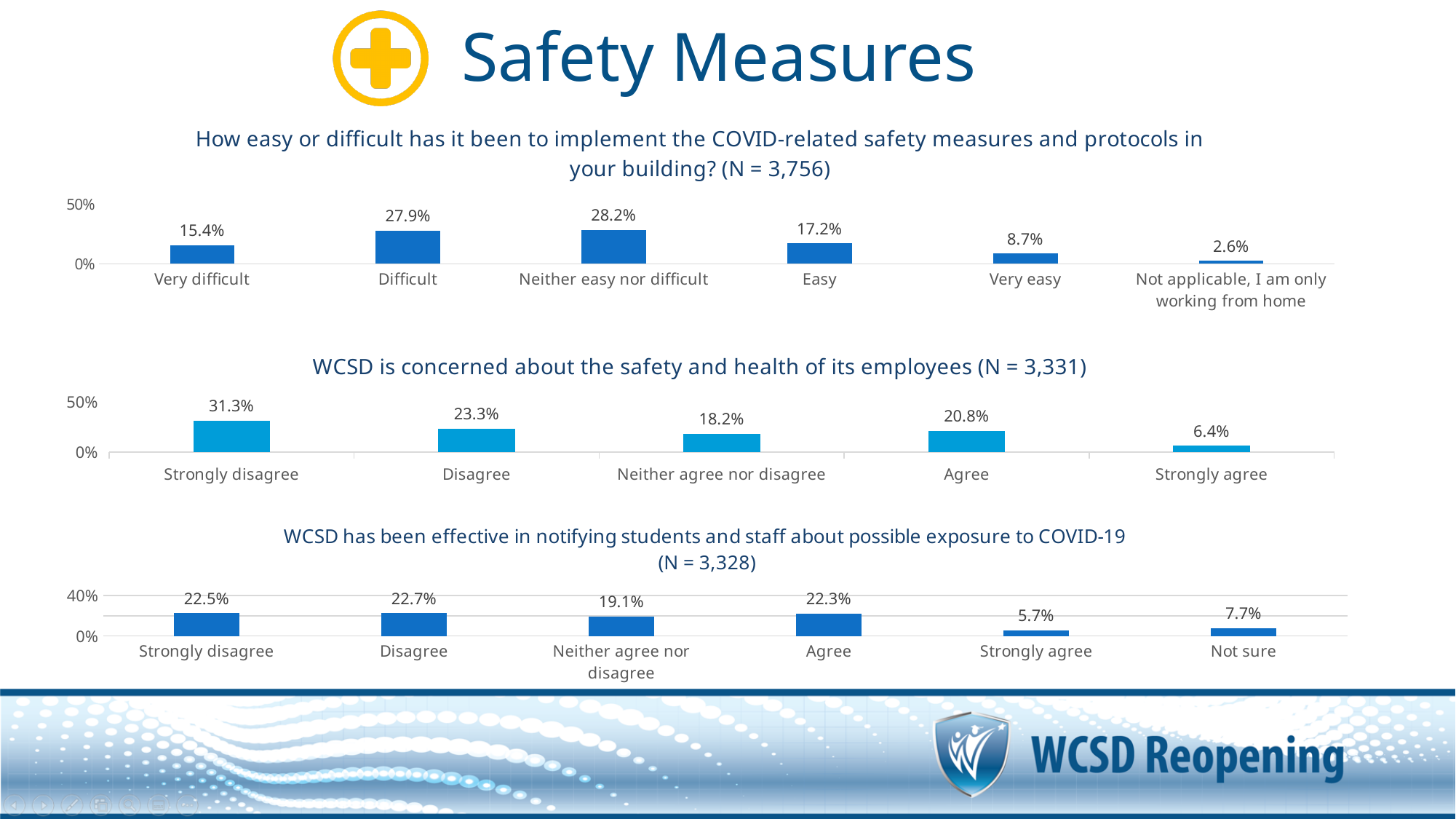
In the middle chart (WCSD is concerned about the safety and health of its employees), which category has the highest value? Strongly disagree In the middle chart (WCSD is concerned about the safety and health of its employees), what is the value for Agree? 20.8% In the top chart (How easy or difficult has it been to implement the COVID-related safety measures), what is the difference between Easy and Very easy? 8.5% In the bottom chart (WCSD has been effective in notifying students and staff about possible exposure to COVID-19), what is the difference between Disagree and Neither agree nor disagree? 3.6% In the bottom chart (WCSD has been effective in notifying students and staff about possible exposure to COVID-19), which category has the lowest value? Strongly agree What kind of chart is the top chart on the slide? Bar chart In the top chart (How easy or difficult has it been to implement the COVID-related safety measures), how many categories are shown? 6 In the middle chart (WCSD is concerned about the safety and health of its employees), which is larger, Disagree or Neither agree nor disagree? Disagree In the top chart (How easy or difficult has it been to implement the COVID-related safety measures), which category has the lowest value? Not applicable, I am only working from home In the middle chart (WCSD is concerned about the safety and health of its employees), how many categories are shown? 5 In the bottom chart (WCSD has been effective in notifying students and staff about possible exposure to COVID-19), what is the value for Not sure? 7.7% In the top chart (How easy or difficult has it been to implement the COVID-related safety measures), what is the value for Difficult? 27.9%